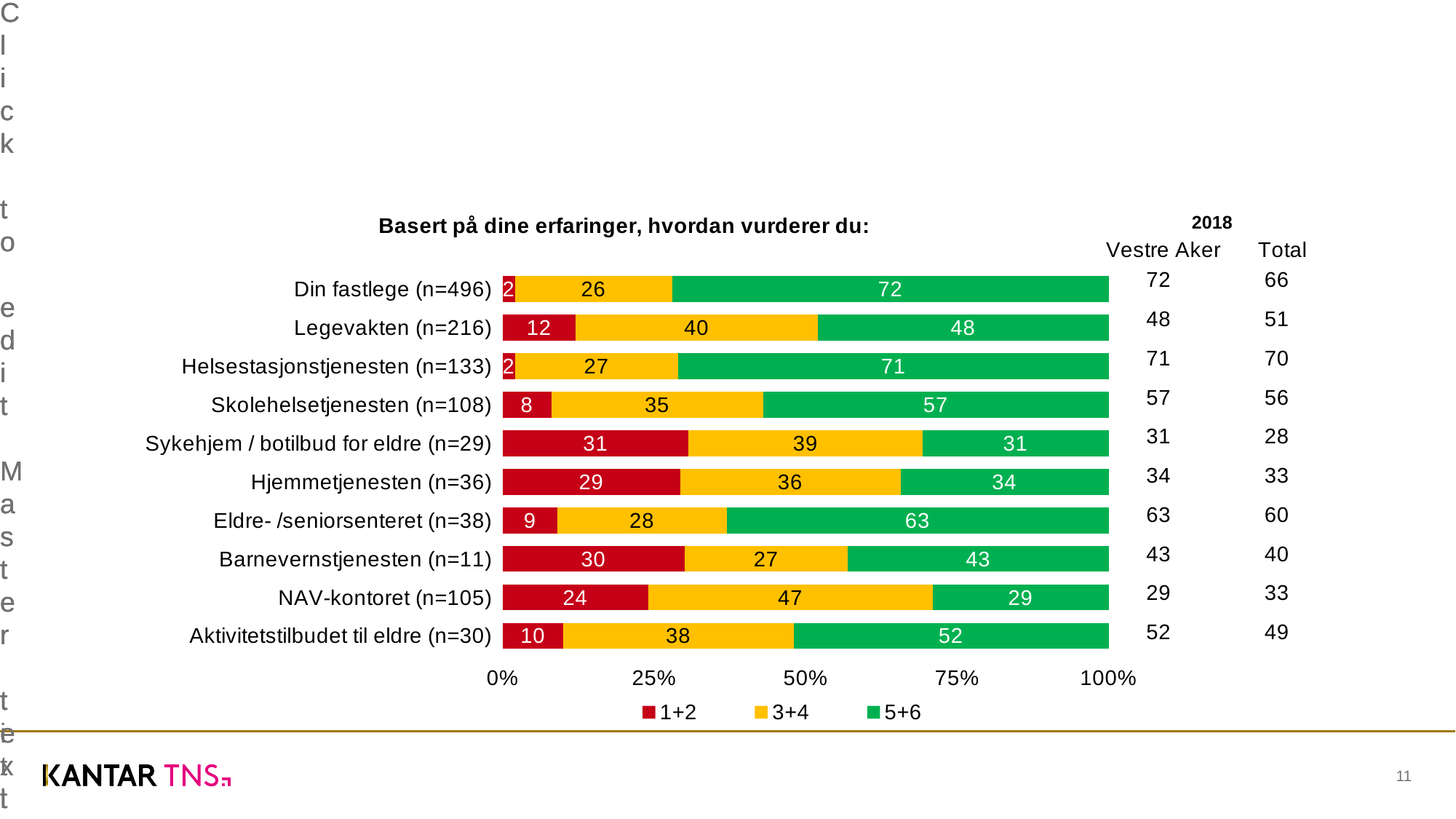
How many series does the legend list? 3 Which category has the highest value for the 3+4 series? NAV-kontoret (n=105) What is the value of the 1+2 series for Sykehjem / botilbud for eldre (n=29)? 31 Which category has the highest value for the 5+6 series? Din fastlege (n=496) What is the difference between the 5+6 values for Din fastlege (n=496) and Legevakten (n=216)? 24 What kind of chart is shown on the slide? Stacked bar chart What is the value of the 5+6 series for Din fastlege (n=496)? 72 Which is larger: the 5+6 value for Eldre- /seniorsenteret (n=38) or for Aktivitetstilbudet til eldre (n=30)? Eldre- /seniorsenteret (n=38) How many categories are shown in the chart? 10 Which category has the lowest value for the 5+6 series? NAV-kontoret (n=105) What is the value of the 3+4 series for NAV-kontoret (n=105)? 47 What is the total of the stacked bar for Legevakten (n=216)? 100